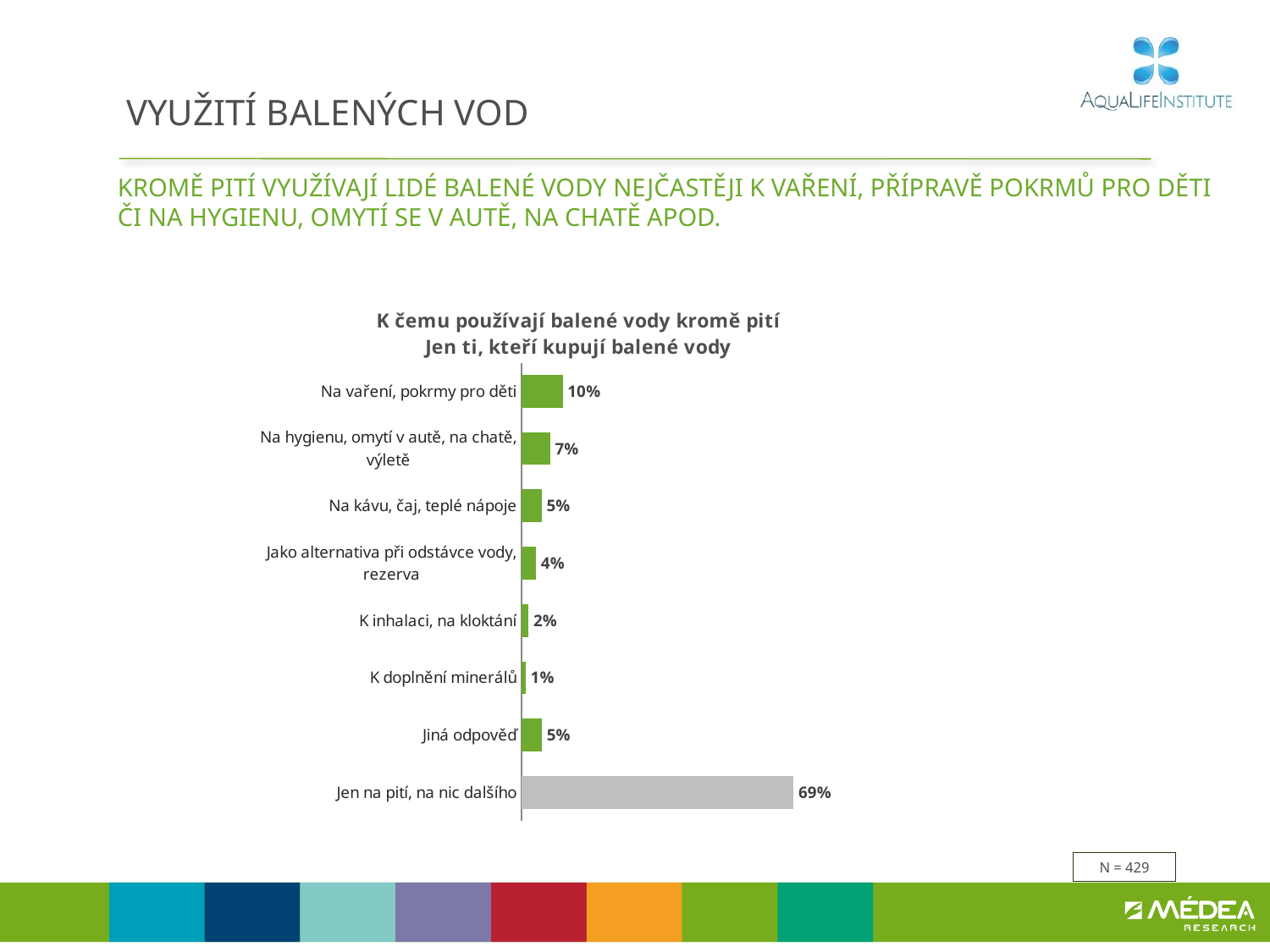
What is the value for "K inhalaci, na kloktání"? 2% Which category has the lowest value? K doplnění minerálů Which category's bar is coloured grey rather than green? Jen na pití, na nic dalšího What is the difference between "Na hygienu, omytí v autě, na chatě, výletě" and "Jako alternativa při odstávce vody, rezerva"? 3% What is the value for "Jen na pití, na nic dalšího"? 69% What is the title of the chart? K čemu používají balené vody kromě pití Jen ti, kteří kupují balené vody Which is larger, "Na kávu, čaj, teplé nápoje" or "Na hygienu, omytí v autě, na chatě, výletě"? Na hygienu, omytí v autě, na chatě, výletě How many categories does the chart show? 8 What is the difference between "Jen na pití, na nic dalšího" and "Na vaření, pokrmy pro děti"? 59% What is the value for "Na vaření, pokrmy pro děti"? 10% Which category has the highest value? Jen na pití, na nic dalšího What kind of chart is shown on the slide? Bar chart